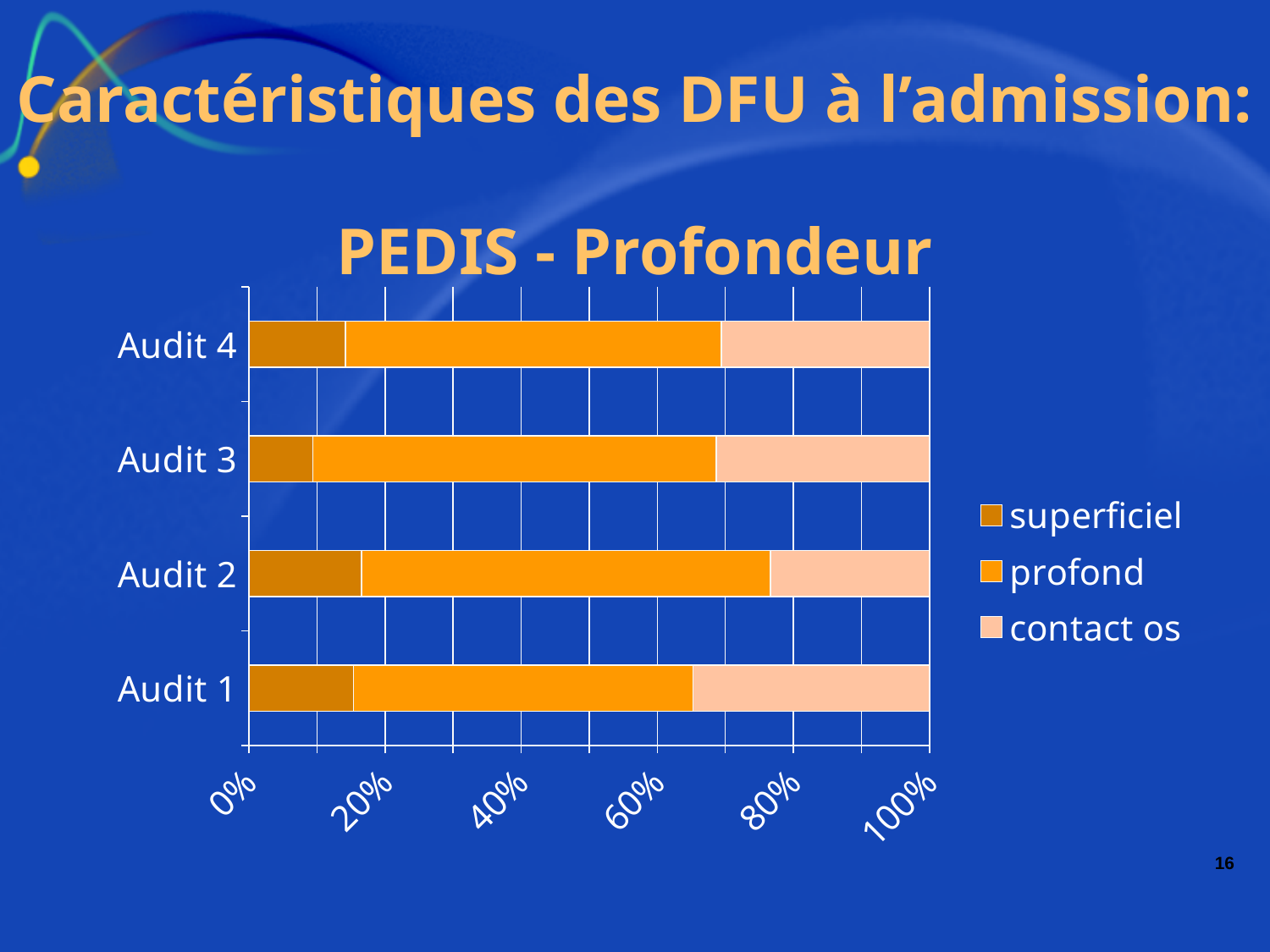
What is the title of the chart? PEDIS - Profondeur How many audits (categories) are plotted on the chart? 4 What kind of chart is shown on the slide? stacked bar chart Which series is shown in the lightest (pale pink) colour in the legend? contact os Which audit has the smallest 'superficiel' share? Audit 3 Is the 'profond' share for Audit 2 greater or less than 40%? greater Is the 'superficiel' share for Audit 3 greater or less than 20%? less Is the 'superficiel' share for Audit 4 greater or less than 20%? less Which has the larger 'contact os' share, Audit 1 or Audit 2? Audit 1 Which audit has the smallest 'contact os' share? Audit 2 How many series does the legend list? 3